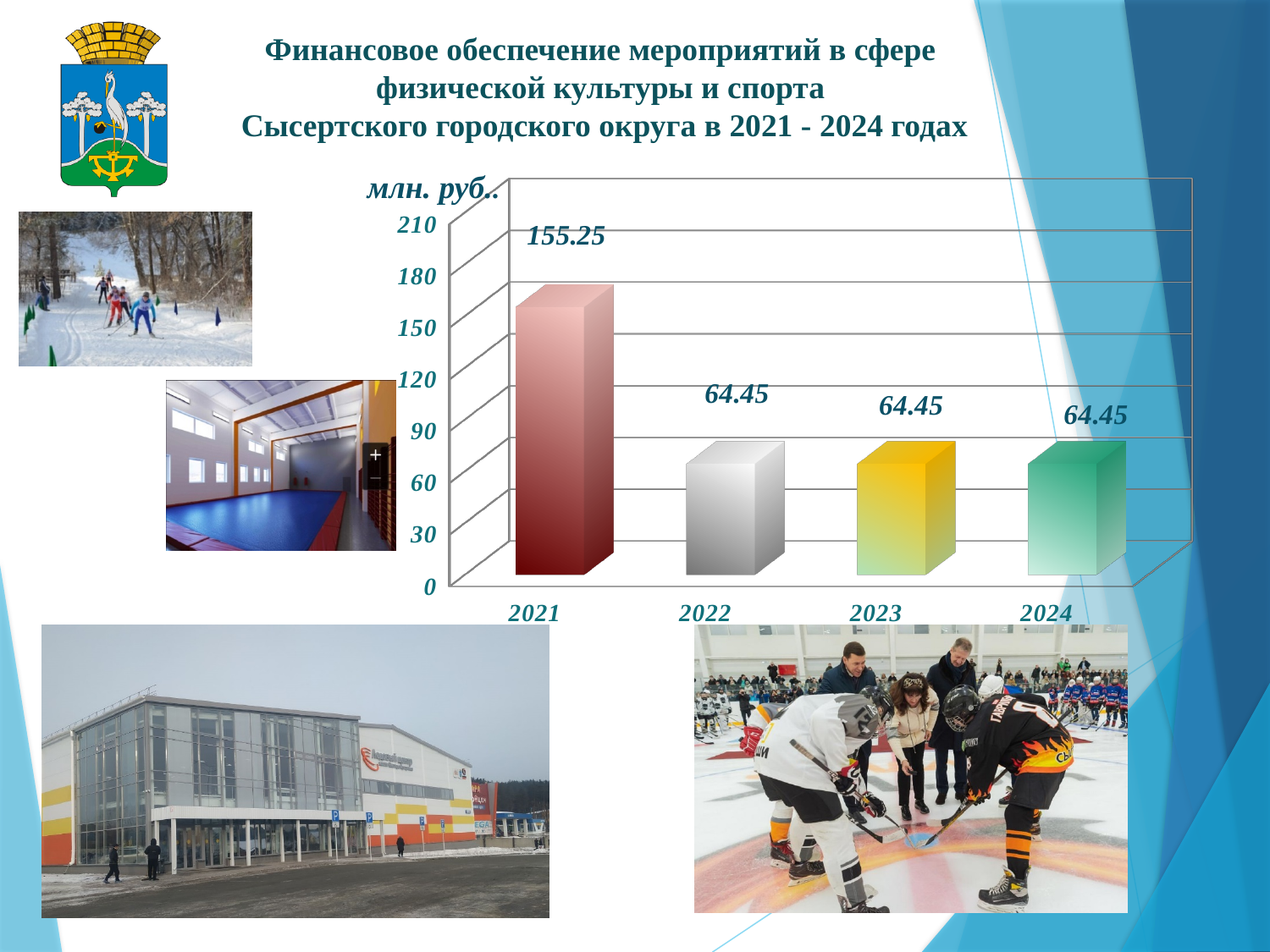
How many years are shown on the x axis? 4 Is the value for 2021 greater or less than 120? greater Is the value for 2023 greater or less than 90? less What is the value for 2024? 64.45 What kind of chart is shown on the slide? bar chart What is the difference between the values for 2021 and 2022? 90.8 Which year has the highest value? 2021 What unit is shown on the vertical axis of the chart? млн. руб. Which is larger, the value for 2021 or the value for 2023? 2021 What is the value for 2021? 155.25 What is the value for 2022? 64.45 Do the values rise or fall from 2021 to 2022? fall